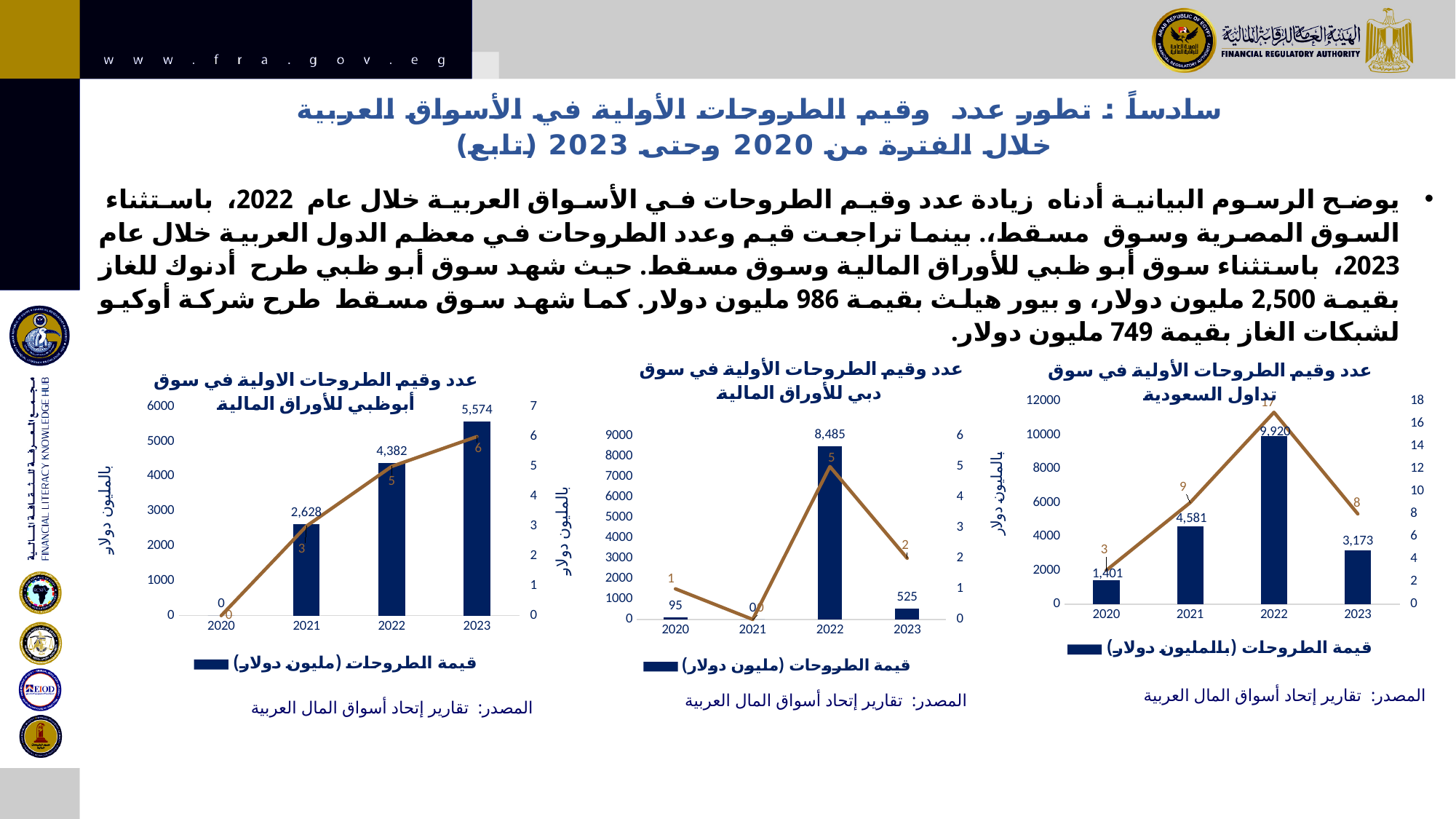
In the right chart (Saudi Tadawul IPOs), is the IPO value for 2022 larger or smaller than the value for 2023? larger In the left chart (Abu Dhabi Securities Exchange IPOs), what is the value of IPOs in 2021? 2,628 How many years are shown on the x axis of the left chart (Abu Dhabi Securities Exchange IPOs)? 4 In the right chart (Saudi Tadawul IPOs), what is the IPO value in 2021? 4,581 In the middle chart (Dubai Financial Market IPOs), which year has the highest IPO value? 2022 In the right chart (Saudi Tadawul IPOs), how many IPOs does the line show for 2022? 17 In the left chart (Abu Dhabi Securities Exchange IPOs), how many IPOs does the line show for 2022? 5 In the right chart (Saudi Tadawul IPOs), which year has the lowest IPO value? 2020 In the left chart (Abu Dhabi Securities Exchange IPOs), what is the value of IPOs in 2023? 5,574 In the middle chart (Dubai Financial Market IPOs), what is the IPO value in 2020? 95 In the middle chart (Dubai Financial Market IPOs), what is the IPO value in 2022? 8,485 In the left chart (Abu Dhabi Securities Exchange IPOs), what is the difference in IPO value between 2023 and 2022? 1,192